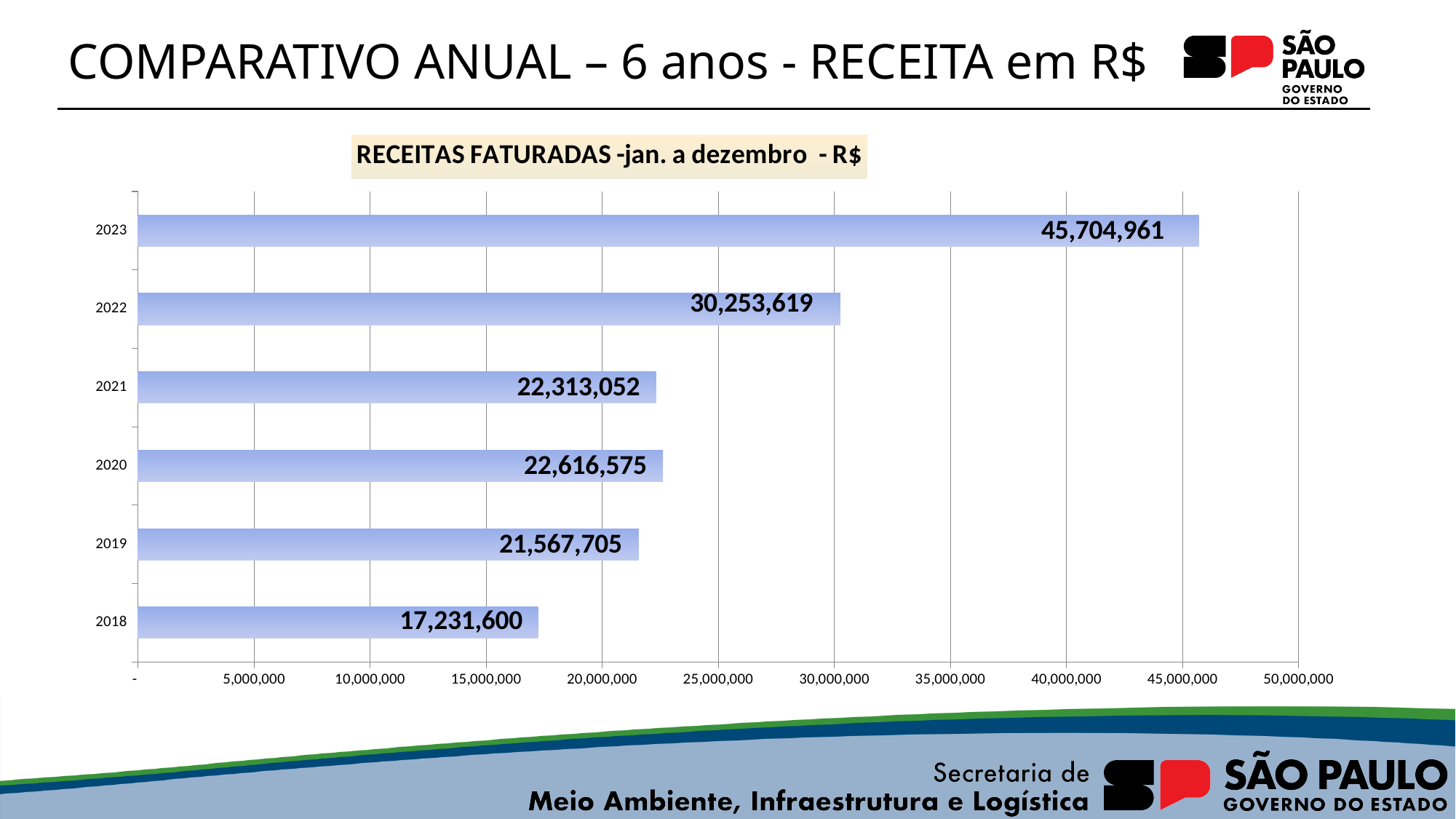
What is the value for 2018? 17,231,600 Is the value for 2019 greater or less than 25,000,000? less How many years are shown in the chart? 6 What is the title of the chart? RECEITAS FATURADAS -jan. a dezembro - R$ What is the value for 2021? 22,313,052 What is the value for 2023? 45,704,961 What is the difference between the values for 2019 and 2018? 4,336,105 Which year has the highest value? 2023 What kind of chart is this? bar chart Which year has the lowest value? 2018 What is the difference between the values for 2023 and 2022? 15,451,342 Which is larger, the value for 2020 or the value for 2021? 2020